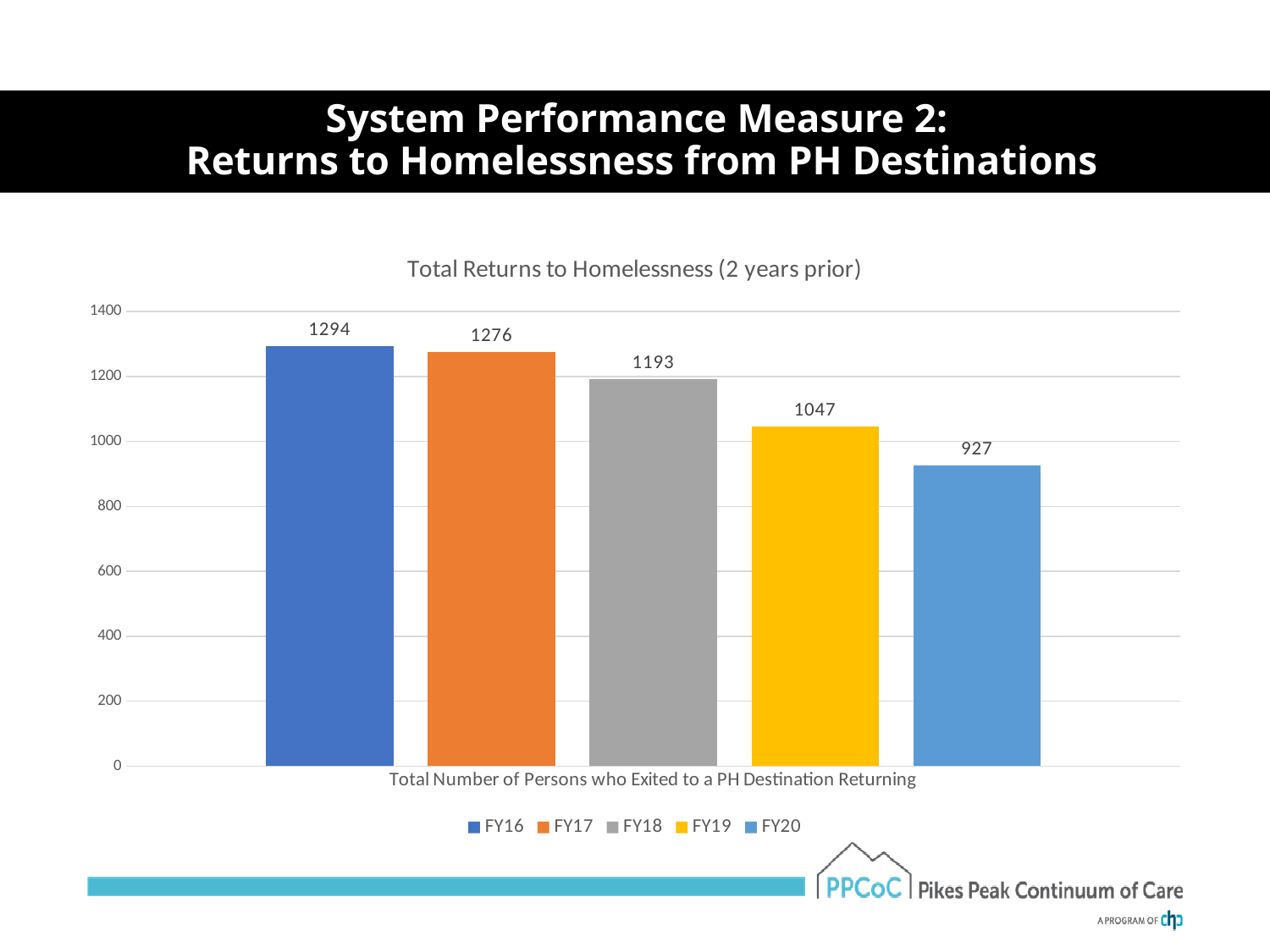
How many series does the legend list? 5 What is the value for FY16? 1294 Do the values rise or fall from FY16 to FY20? Fall What is the difference between the FY18 and FY19 values? 146 Which fiscal year has the highest total returns to homelessness? FY16 What is the value for FY20? 927 What kind of chart is shown on the slide? Bar chart Is the value for FY19 greater or less than 1000? greater Which fiscal year has the lowest total returns to homelessness? FY20 What is the value for FY19? 1047 Which is larger, the value for FY17 or the value for FY18? FY17 What is the difference between the FY16 and FY20 values? 367